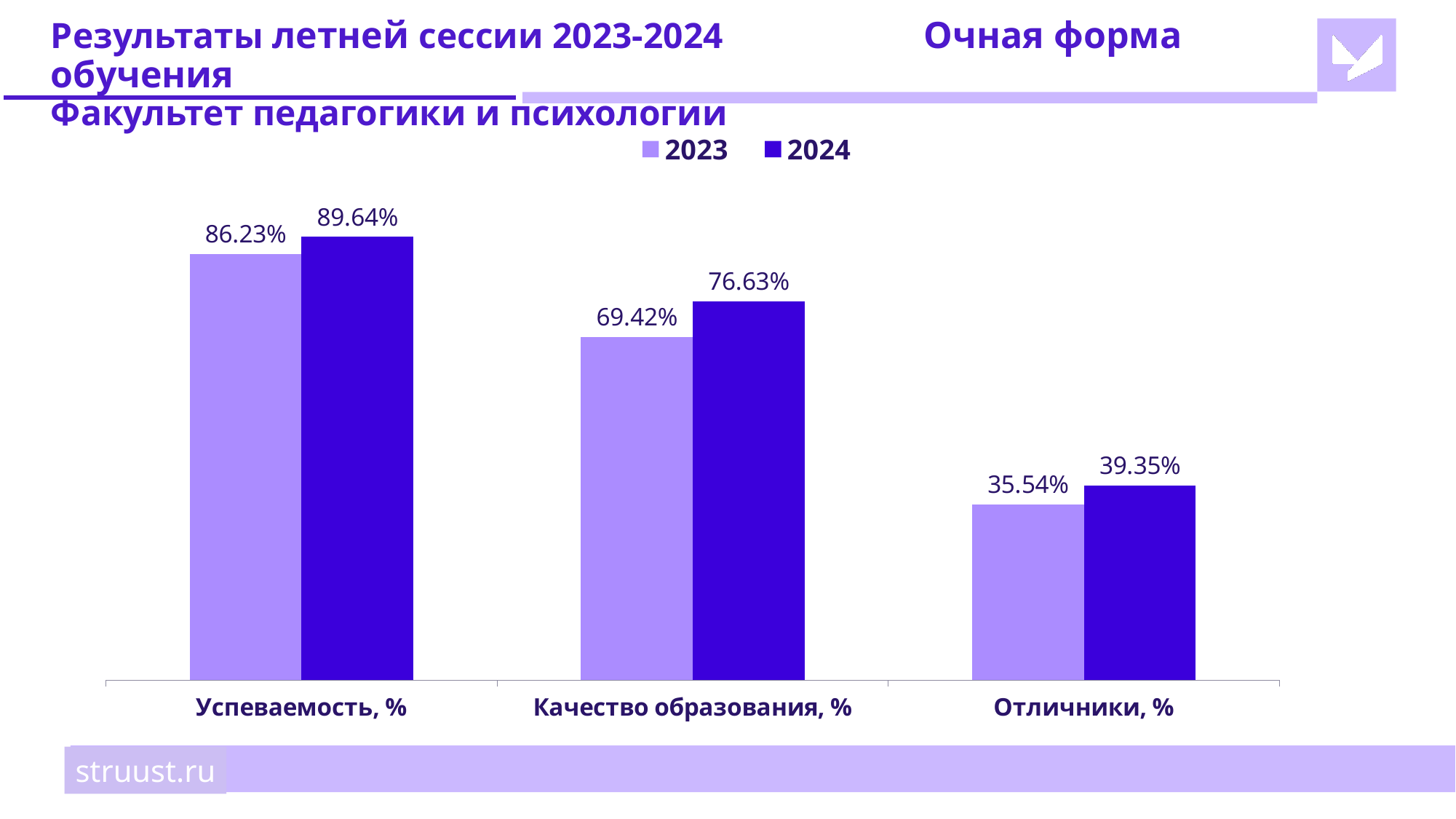
Which category has the highest value in the 2024 series? Успеваемость, % What is the value for Успеваемость, % in 2024? 89.64% What is the difference between the 2024 and 2023 values for Отличники, %? 3.81% How many categories are shown on the x axis? 3 What is the value for Качество образования, % in 2024? 76.63% Which category has the lowest value in the 2023 series? Отличники, % Which is larger for Успеваемость, %: the 2023 value or the 2024 value? 2024 What is the value for Успеваемость, % in 2023? 86.23% What is the value for Отличники, % in 2023? 35.54% What kind of chart is shown on the slide? Bar chart What is the difference between the 2024 and 2023 values for Качество образования, %? 7.21% How many series does the legend list? 2